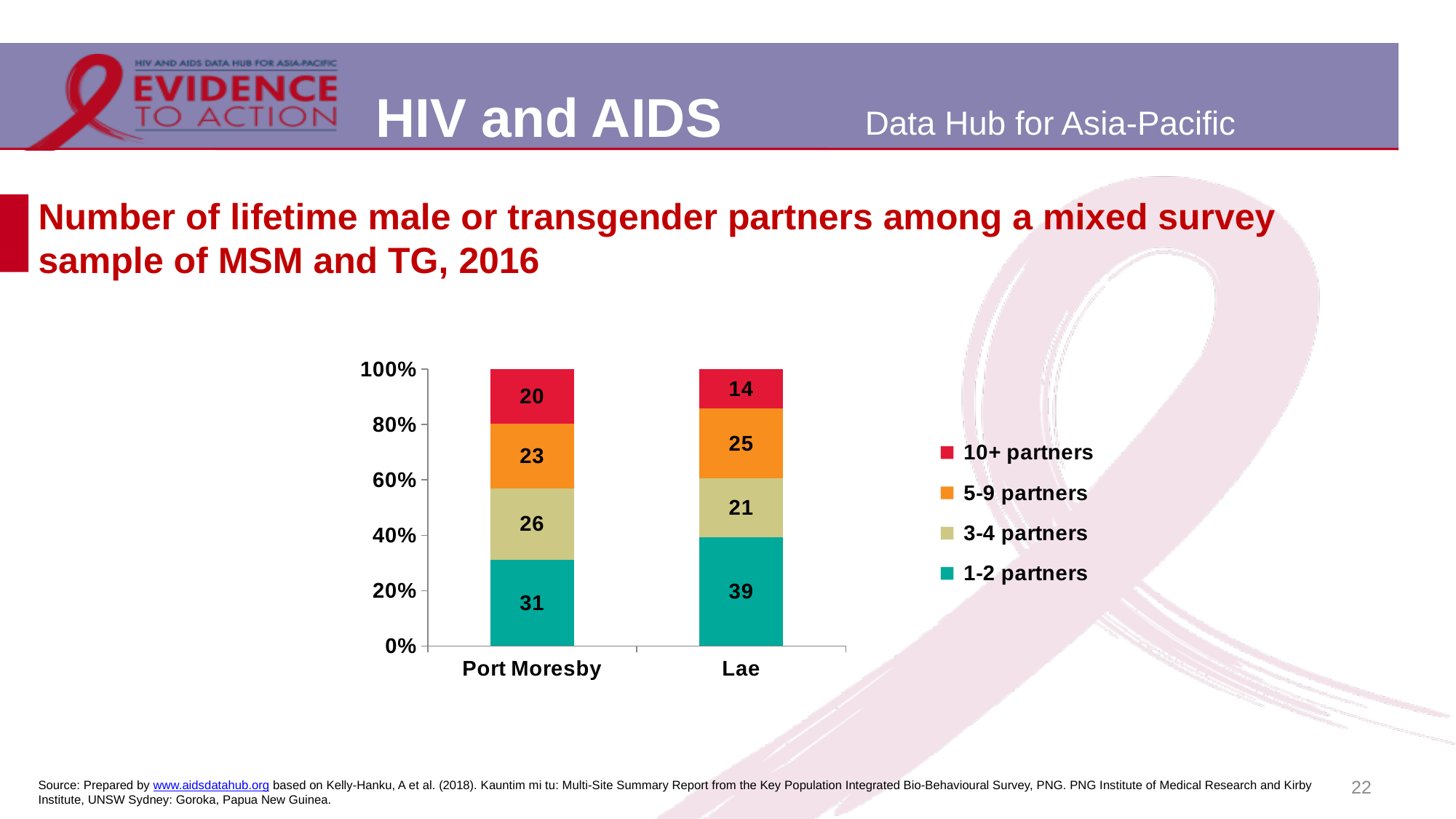
What kind of chart is shown on the slide? Stacked bar chart What is the difference between the 1-2 partners values for Lae and Port Moresby? 8 Which city has the higher value for 1-2 partners, Port Moresby or Lae? Lae What is the value for 1-2 partners in Port Moresby? 31 Which partner category has the largest value in Lae? 1-2 partners What is the value for 5-9 partners in Lae? 25 Which partner category has the smallest value in Lae? 10+ partners What is the difference between the 10+ partners values for Port Moresby and Lae? 6 What is the value for 10+ partners in Lae? 14 What is the value for 3-4 partners in Port Moresby? 26 How many series does the legend list? 4 Which city has the higher value for 10+ partners, Port Moresby or Lae? Port Moresby